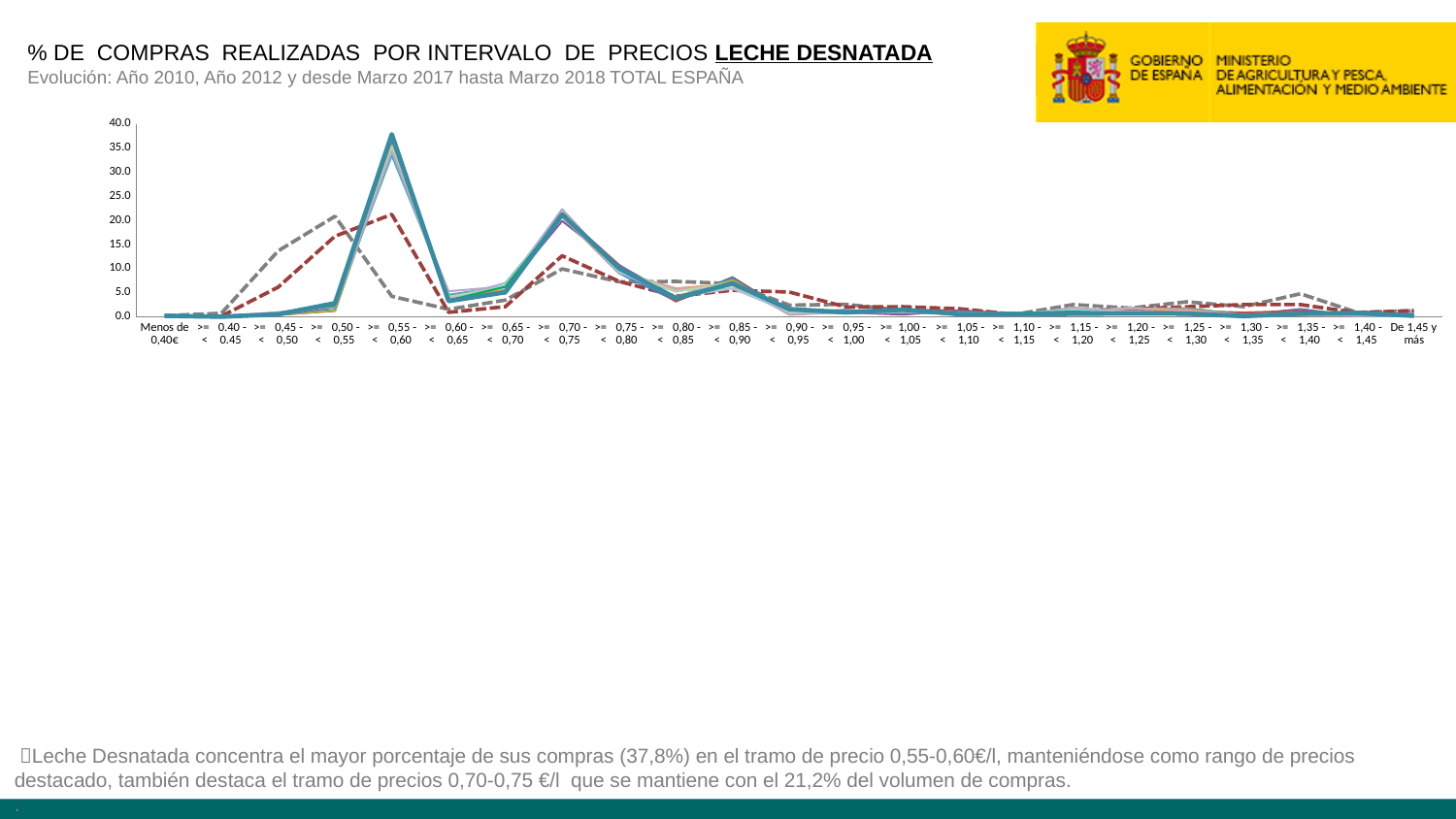
How many price intervals are shown along the x axis of the chart? 23 Is the value of the solid lines at the >= 1,00 - < 1,05 interval greater or less than 5? less Is the value of the solid lines at the >= 0,70 - < 0,75 interval greater or less than 15? greater Do the solid lines rise or fall from the >= 0,55 - < 0,60 interval to the >= 0,60 - < 0,65 interval? fall Which product is named in the chart title? LECHE DESNATADA Is the value of the solid lines at the 'Menos de 0,40€' interval greater or less than 5? less For the solid lines, which is larger: the value at >= 0,55 - < 0,60 or the value at >= 0,70 - < 0,75? >= 0,55 - < 0,60 In which price interval do the solid lines reach their highest value? >= 0,55 - < 0,60 What is the highest tick value shown on the y axis of the chart? 40.0 What kind of chart is shown on the slide? line chart